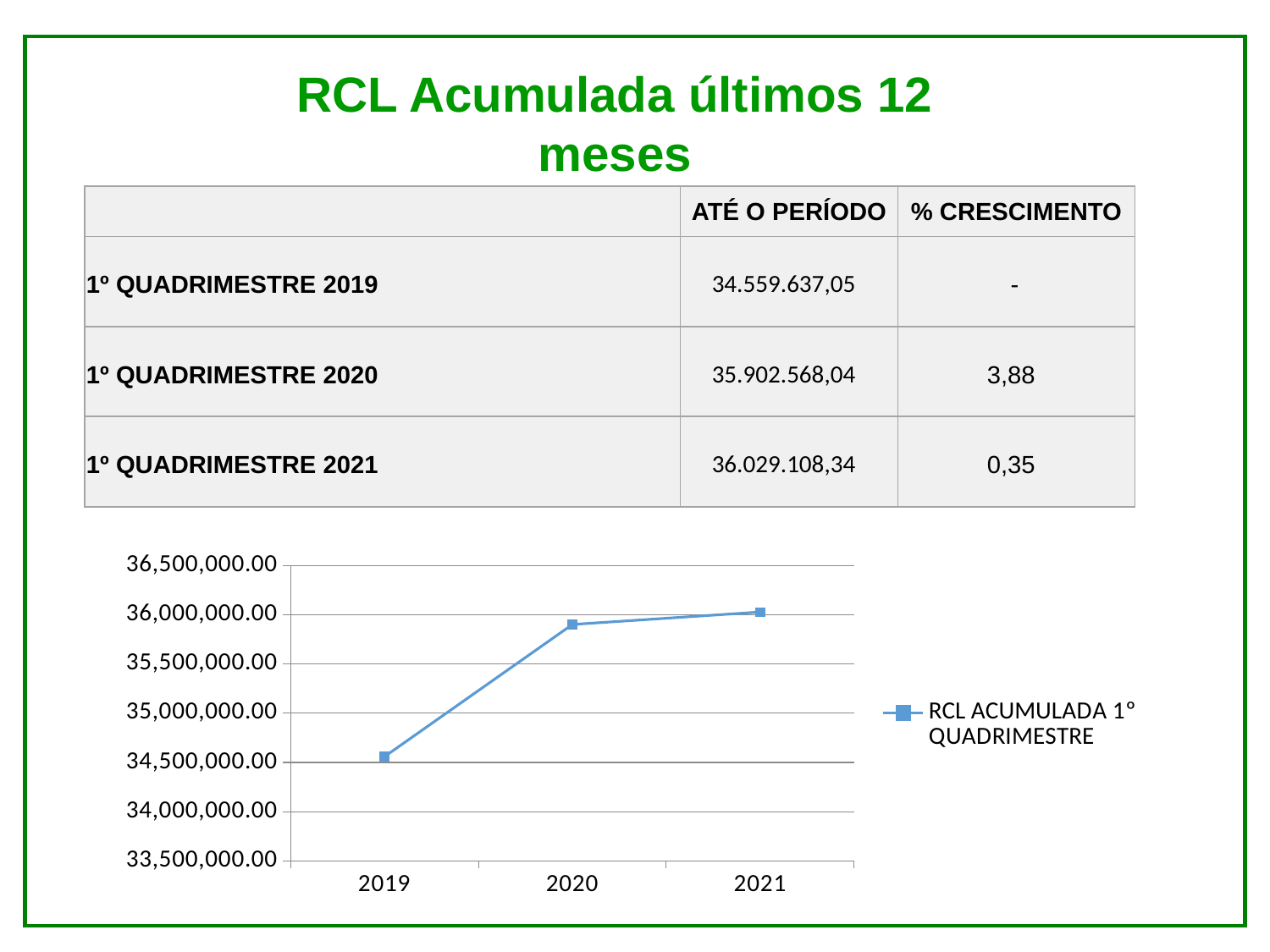
Which is larger on the line chart, the value for 2019 or the value for 2020? 2020 Is the value for 2020 on the line chart greater or less than 35,500,000.00? greater What is the name of the series shown in the chart legend? RCL ACUMULADA 1° QUADRIMESTRE What kind of chart is shown on the slide? line chart Which year has the highest value on the line chart? 2021 Is the value for 2019 on the line chart greater or less than 35,000,000.00? less Which year has the lowest value on the line chart? 2019 Do the values on the line chart rise or fall from 2019 to 2021? rise Is the value for 2021 on the line chart greater or less than 35,500,000.00? greater How many data points are plotted on the line chart? 3 How many series does the chart legend list? 1 What is the lowest value shown on the vertical axis of the chart? 33,500,000.00